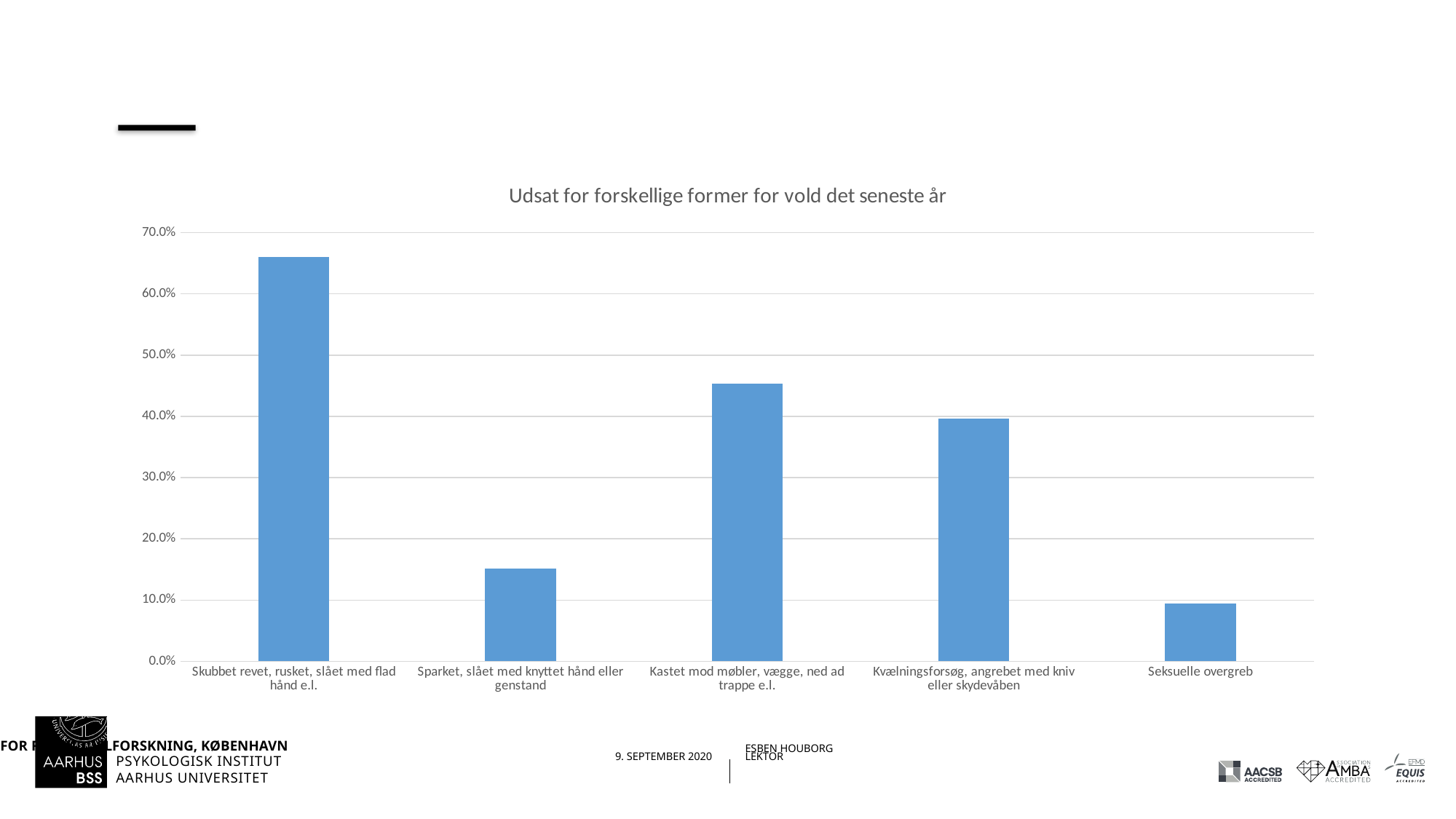
What is the title of the chart? Udsat for forskellige former for vold det seneste år Is the value for 'Sparket, slået med knyttet hånd eller genstand' greater or less than 20.0%? less Is the value for 'Kastet mod møbler, vægge, ned ad trappe e.l.' greater or less than 40.0%? greater Which is larger: the value for 'Kastet mod møbler, vægge, ned ad trappe e.l.' or the value for 'Kvælningsforsøg, angrebet med kniv eller skydevåben'? Kastet mod møbler, vægge, ned ad trappe e.l. Is the value for 'Kvælningsforsøg, angrebet med kniv eller skydevåben' greater or less than 30.0%? greater Which category has the highest value? Skubbet revet, rusket, slået med flad hånd e.l. Which is larger: the value for 'Sparket, slået med knyttet hånd eller genstand' or the value for 'Seksuelle overgreb'? Sparket, slået med knyttet hånd eller genstand What type of chart is shown on the slide? Bar chart How many categories are shown on the x axis of the chart? 5 Which category has the lowest value? Seksuelle overgreb